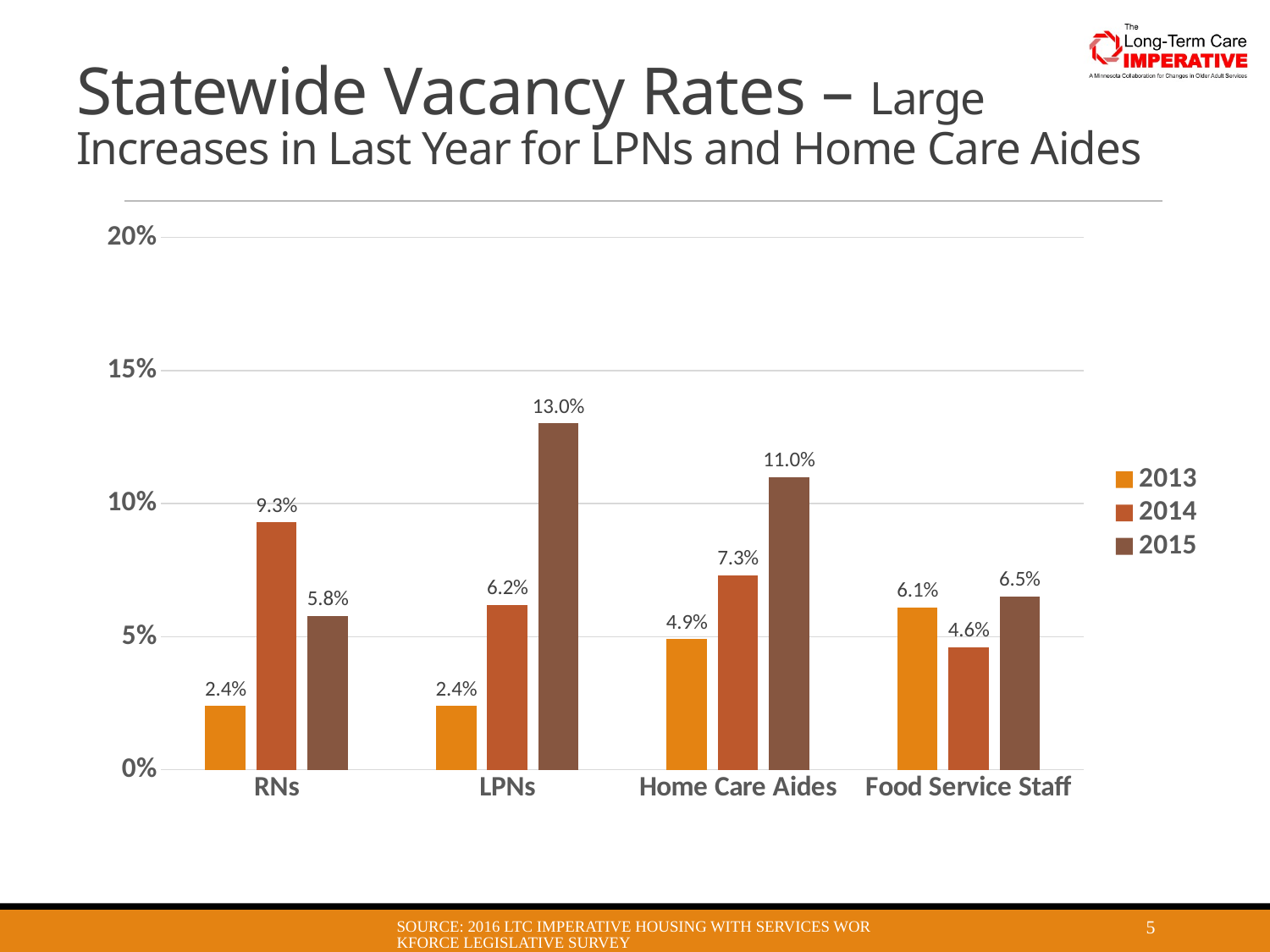
What was the vacancy rate for Food Service Staff in 2014? 4.6% Which category had the highest vacancy rate in 2015? LPNs What is the difference between the 2014 and 2013 vacancy rates for RNs? 6.9% What was the vacancy rate for LPNs in 2015? 13.0% Which is larger, the 2015 vacancy rate for RNs or the 2015 vacancy rate for Food Service Staff? Food Service Staff What is the difference between the 2015 and 2014 vacancy rates for LPNs? 6.8% Did the vacancy rate for Home Care Aides rise or fall from 2013 to 2015? Rise How many job categories are shown on the x axis? 4 What kind of chart is shown on the slide? Bar chart How many series does the legend list? 3 What was the vacancy rate for Home Care Aides in 2013? 4.9% Which category had the lowest vacancy rate in 2014? Food Service Staff